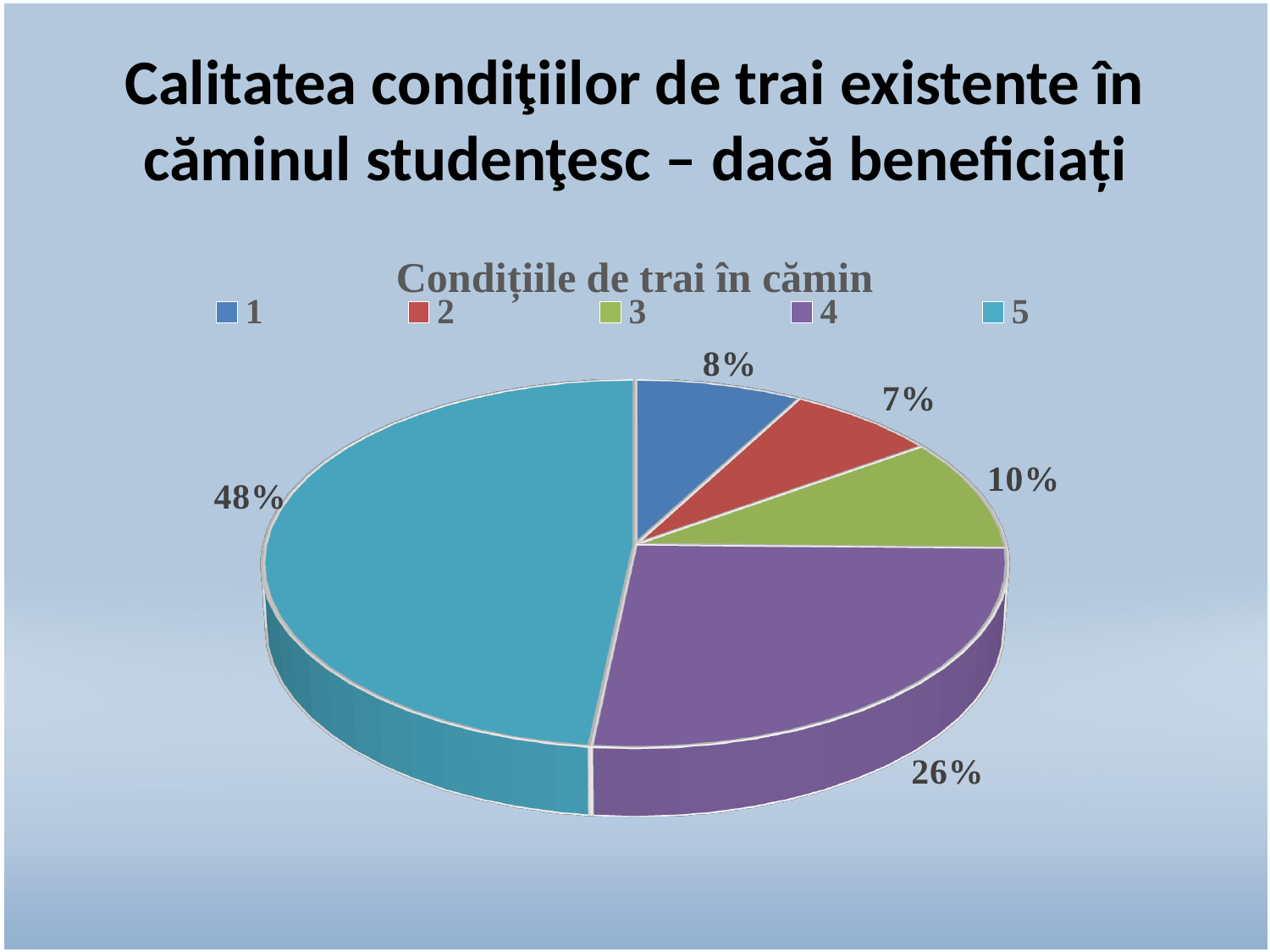
What is the value for category 3? 10% How many categories does the legend list? 5 What share of the pie does category 5 have? 48% What kind of chart is shown on the slide? pie chart What is the chart's title? Condițiile de trai în cămin Which category has the smallest share? 2 What is the value for category 2? 7% What is the value for category 1? 8% What share of the pie does category 4 have? 26% What is the difference between the shares of category 5 and category 4? 22% Which is larger, the share for category 3 or the share for category 1? 3 Which category has the largest share? 5